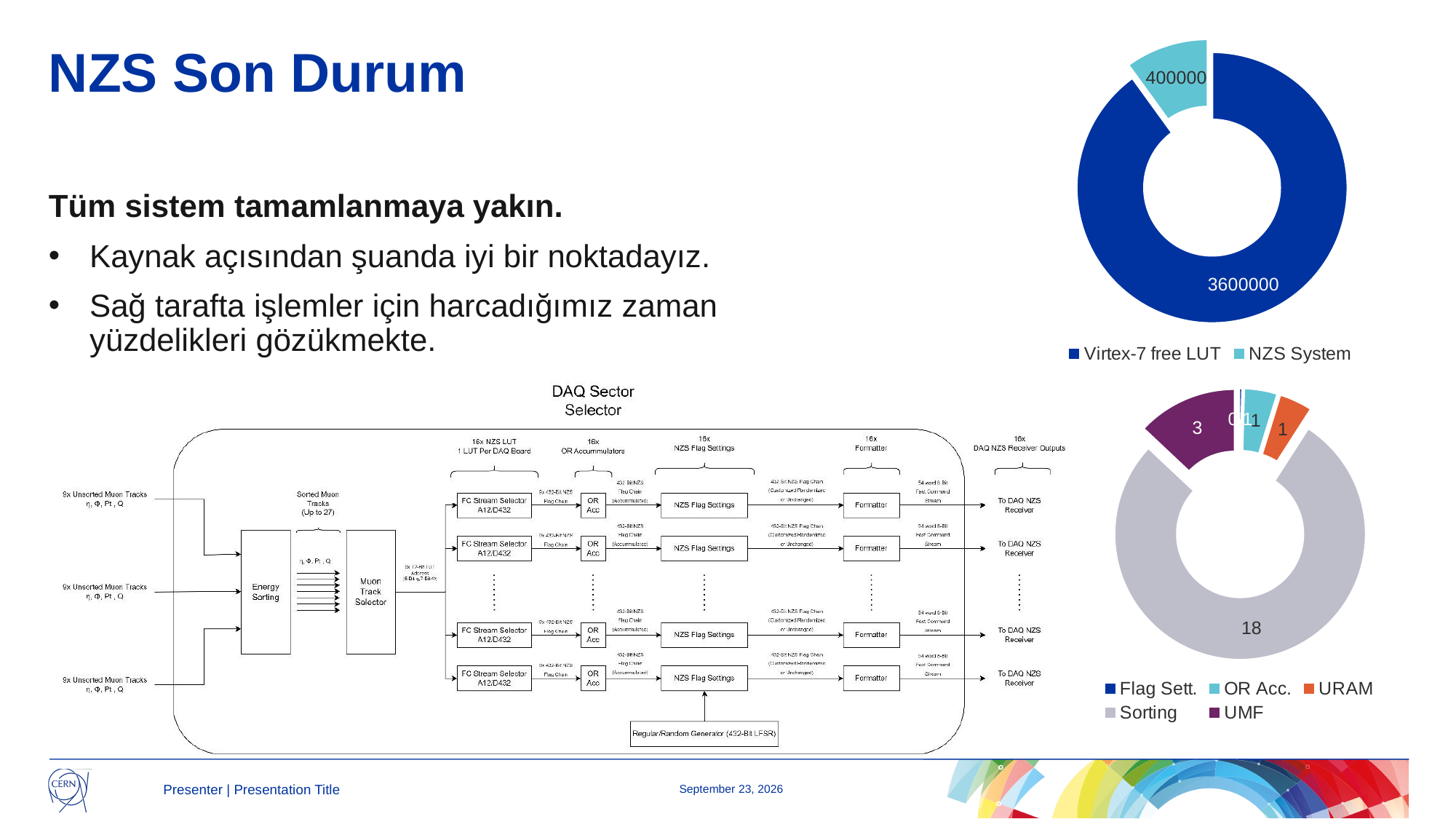
In the top doughnut chart, what is the value for NZS System? 400000 In the top doughnut chart, what is the value for Virtex-7 free LUT? 3600000 In the top doughnut chart, how many series does the legend list? 2 In the bottom doughnut chart, which category has the largest value? Sorting In the bottom doughnut chart, what is the value for URAM? 1 In the bottom doughnut chart, which is larger, Sorting or UMF? Sorting In the bottom doughnut chart, what is the value for Sorting? 18 In the bottom doughnut chart, what is the value for UMF? 3 In the top doughnut chart, what share of the total does NZS System represent? 10% In the top doughnut chart, what is the difference between the Virtex-7 free LUT value and the NZS System value? 3200000 In the bottom doughnut chart, how many categories does the legend list? 5 What kind of chart is the chart in the top right of the slide? Doughnut chart